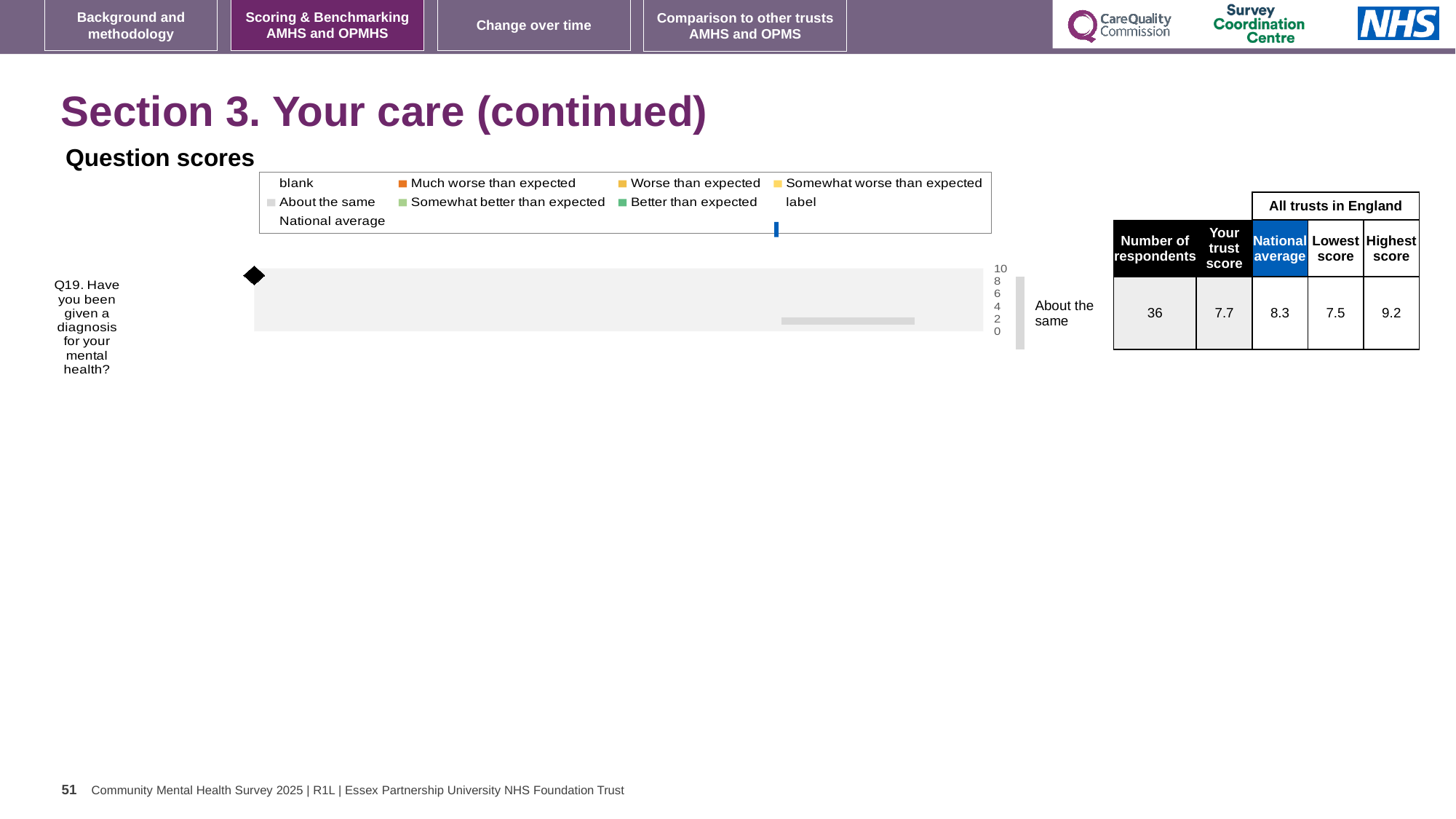
Is the trust score for Q19 greater or less than 8? less For Q19, which is larger: the trust score or the national average? national average What is the difference between the highest score and the lowest score for Q19? 1.7 How many survey questions are plotted in the Question scores chart? 1 What is the highest score among all trusts in England for Q19? 9.2 What benchmark category is shown next to the bar for Q19? About the same What is the national average score for Q19? 8.3 What is the lowest score among all trusts in England for Q19? 7.5 How many respondents answered Q19? 36 What kind of chart is shown under 'Question scores'? bar chart By how much does the national average exceed the trust score for Q19? 0.6 What is the trust score for Q19 (Have you been given a diagnosis for your mental health?)? 7.7